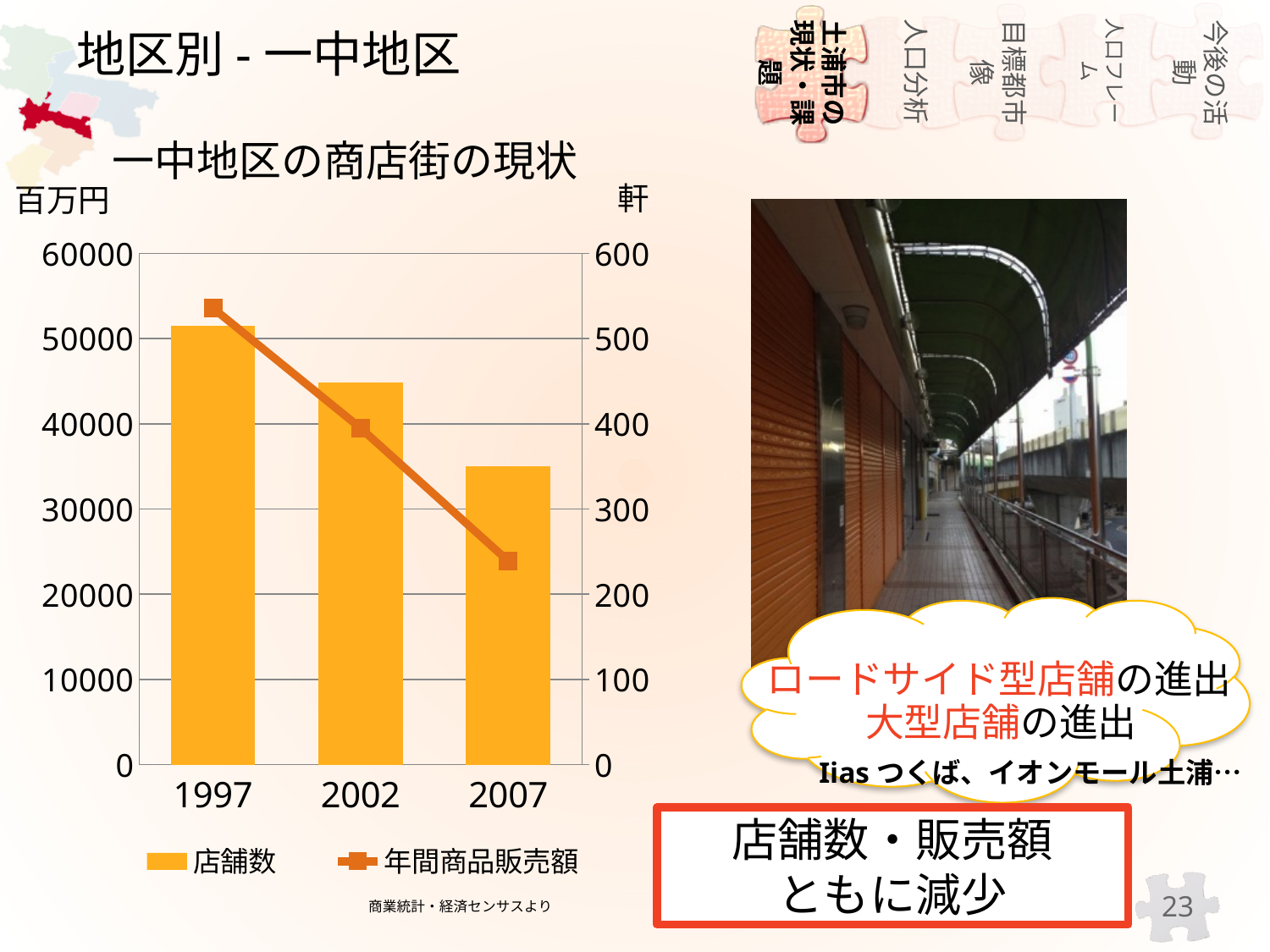
Which year has the shortest bar in the chart? 2007 How many years are shown on the x axis of the chart? 3 Which series in the legend is drawn as bars? 店舗数 Do the bar values rise or fall from 1997 to 2007? Fall Which year has the tallest bar in the chart? 1997 How many series does the chart legend list? 2 Does the 年間商品販売額 line rise or fall from 1997 to 2007? Fall What kind of chart is shown on the slide? A combined bar and line chart Is the bar value for 2007 greater or less than 40000? less